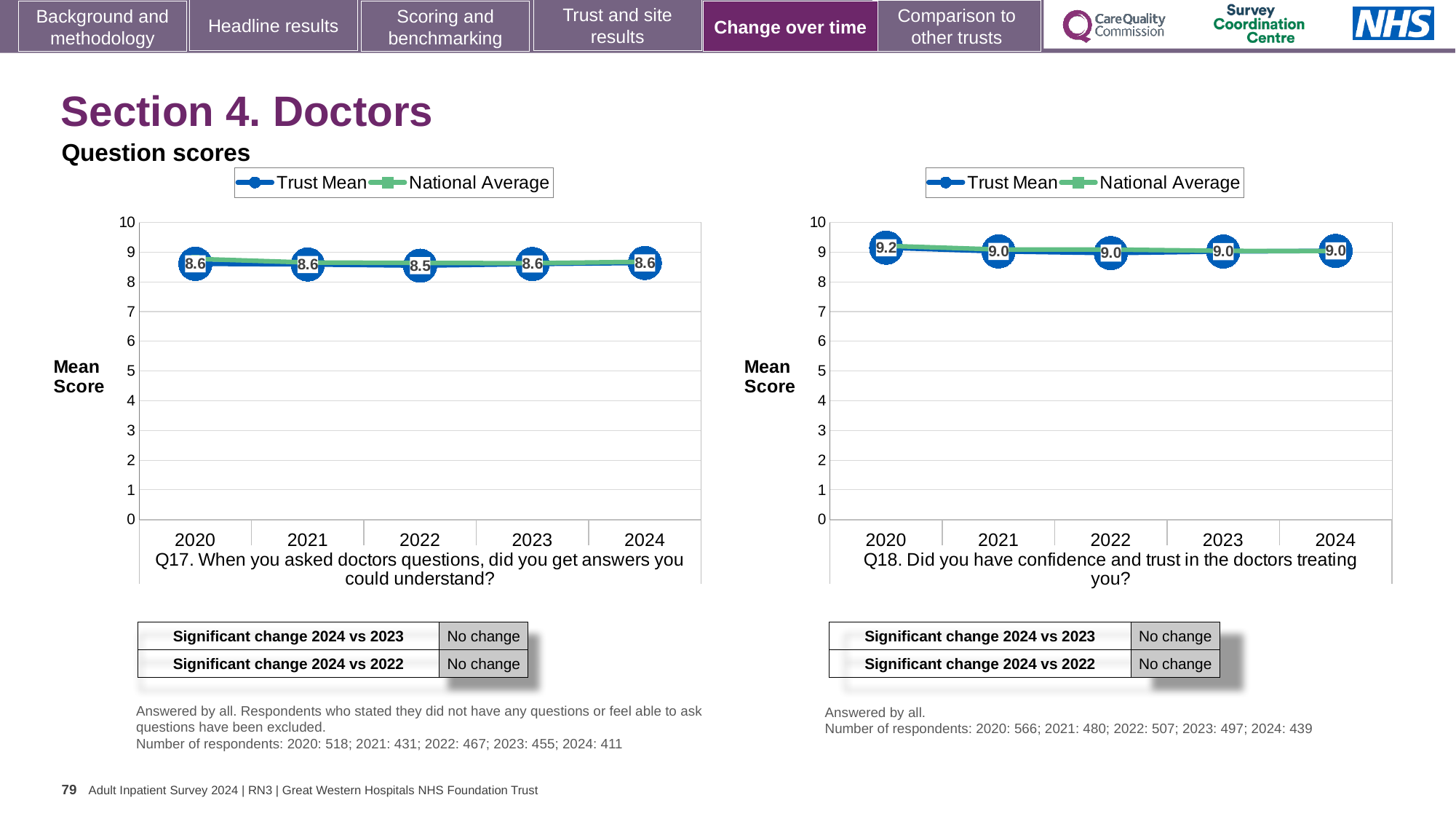
In the Q18 chart (right), what is the difference between the Trust Mean scores for 2020 and 2024? 0.2 In the Q18 chart (right), which year has the highest Trust Mean score? 2020 In the Q17 chart (left), what is the Trust Mean score for 2022? 8.5 In the Q18 chart (right), what is the Trust Mean score for 2023? 9.0 In the Q18 chart (right), is the Trust Mean score for 2020 larger or smaller than the score for 2021? larger How many years are plotted on the x axis of the Q17 chart (left)? 5 How many series does the legend of the Q18 chart (right) list? 2 In the Q17 chart (left), which year has the lowest Trust Mean score? 2022 In the Q17 chart (left), is the Trust Mean value for 2023 greater or less than 8? greater What type of chart is the Q17 chart (left)? Line chart In the Q17 chart (left), what is the Trust Mean score for 2024? 8.6 In the Q18 chart (right), what is the Trust Mean score for 2020? 9.2